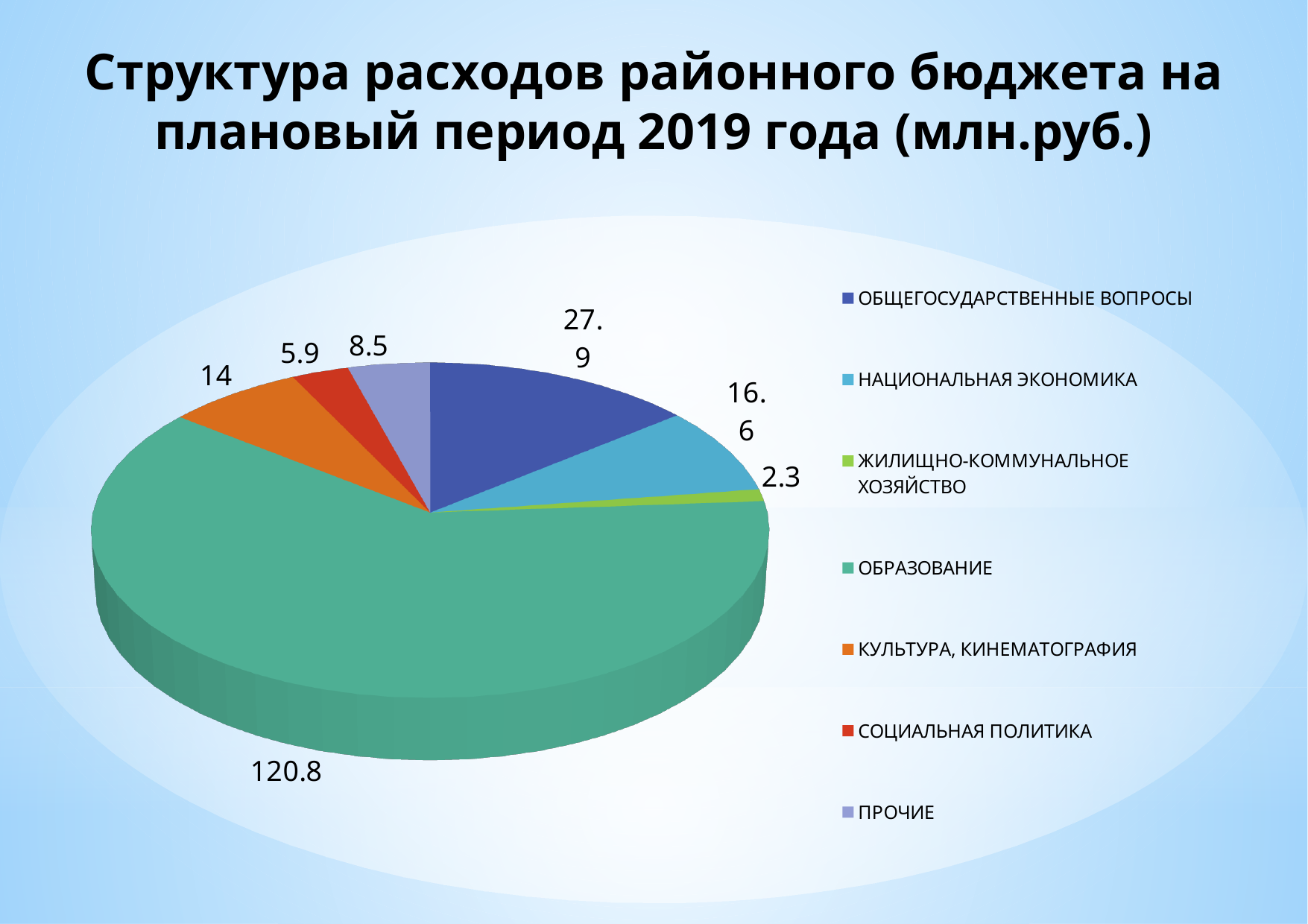
What is the difference between the values for КУЛЬТУРА, КИНЕМАТОГРАФИЯ and СОЦИАЛЬНАЯ ПОЛИТИКА? 8.1 What is the value for ПРОЧИЕ? 8.5 Which is larger, the value for ОБЩЕГОСУДАРСТВЕННЫЕ ВОПРОСЫ or the value for НАЦИОНАЛЬНАЯ ЭКОНОМИКА? ОБЩЕГОСУДАРСТВЕННЫЕ ВОПРОСЫ Which category has the largest slice of the pie? ОБРАЗОВАНИЕ What is the title of the chart on the slide? Структура расходов районного бюджета на плановый период 2019 года (млн.руб.) What type of chart is shown on the slide? Pie chart Which category has the smallest slice of the pie? ЖИЛИЩНО-КОММУНАЛЬНОЕ ХОЗЯЙСТВО What is the value for ОБРАЗОВАНИЕ? 120.8 What is the value for ОБЩЕГОСУДАРСТВЕННЫЕ ВОПРОСЫ? 27.9 How many categories does the legend list? 7 What is the value for ЖИЛИЩНО-КОММУНАЛЬНОЕ ХОЗЯЙСТВО? 2.3 What is the value for НАЦИОНАЛЬНАЯ ЭКОНОМИКА? 16.6